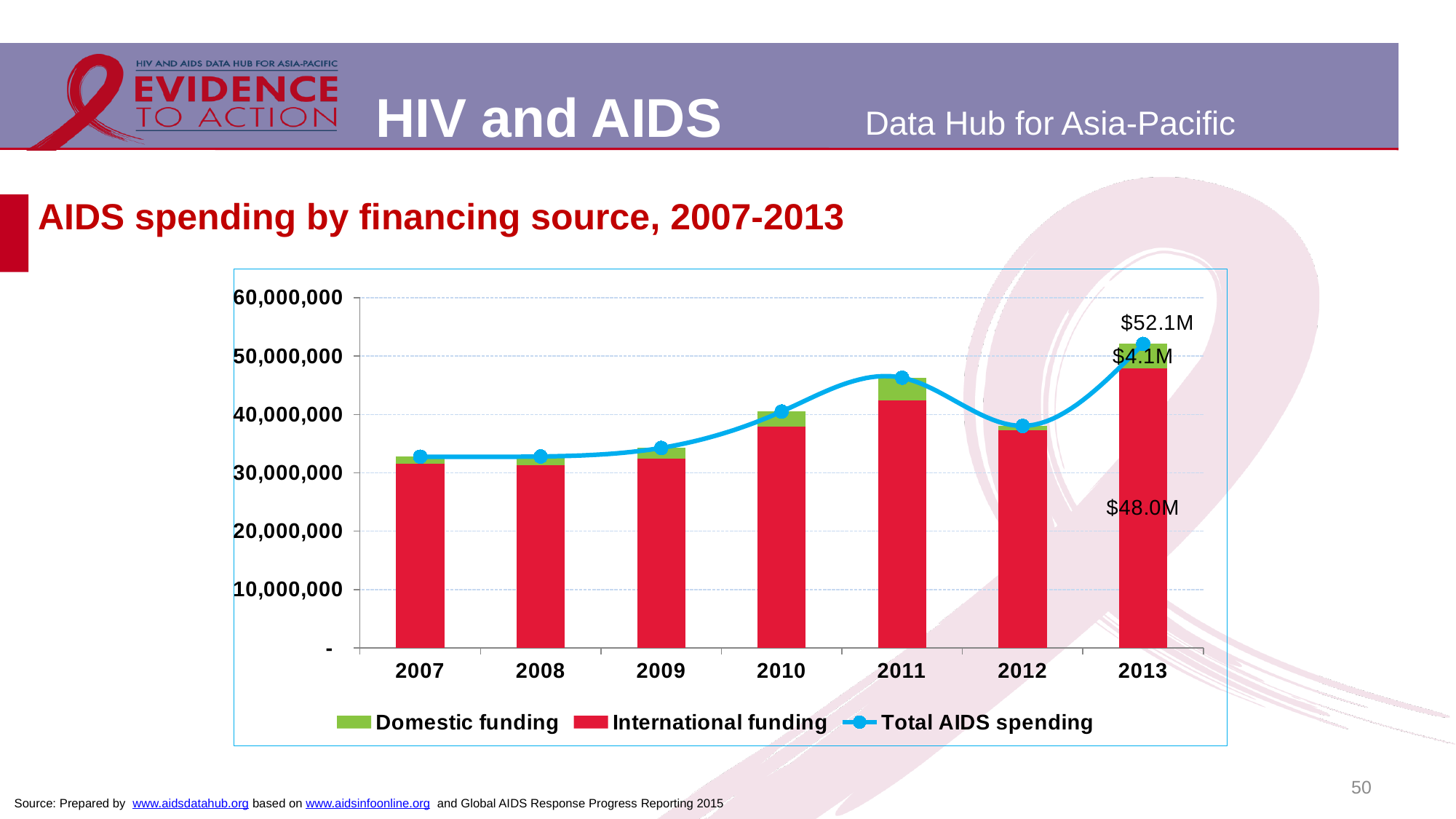
In which year is total AIDS spending highest? 2013 Is the international funding for 2012 greater or less than 40,000,000? less How many series does the legend list? 3 Is the total AIDS spending for 2011 greater or less than 40,000,000? greater What is the international funding value labelled for 2013? $48.0M Is the total AIDS spending for 2007 greater or less than 30,000,000? greater In 2013, how much larger is international funding than domestic funding? $43.8M How many years are shown on the x axis? 7 Does total AIDS spending rise or fall from 2008 to 2011? rise Which year has higher total AIDS spending, 2011 or 2012? 2011 What is the total AIDS spending shown for 2013? $52.1M What is the domestic funding value labelled for 2013? $4.1M